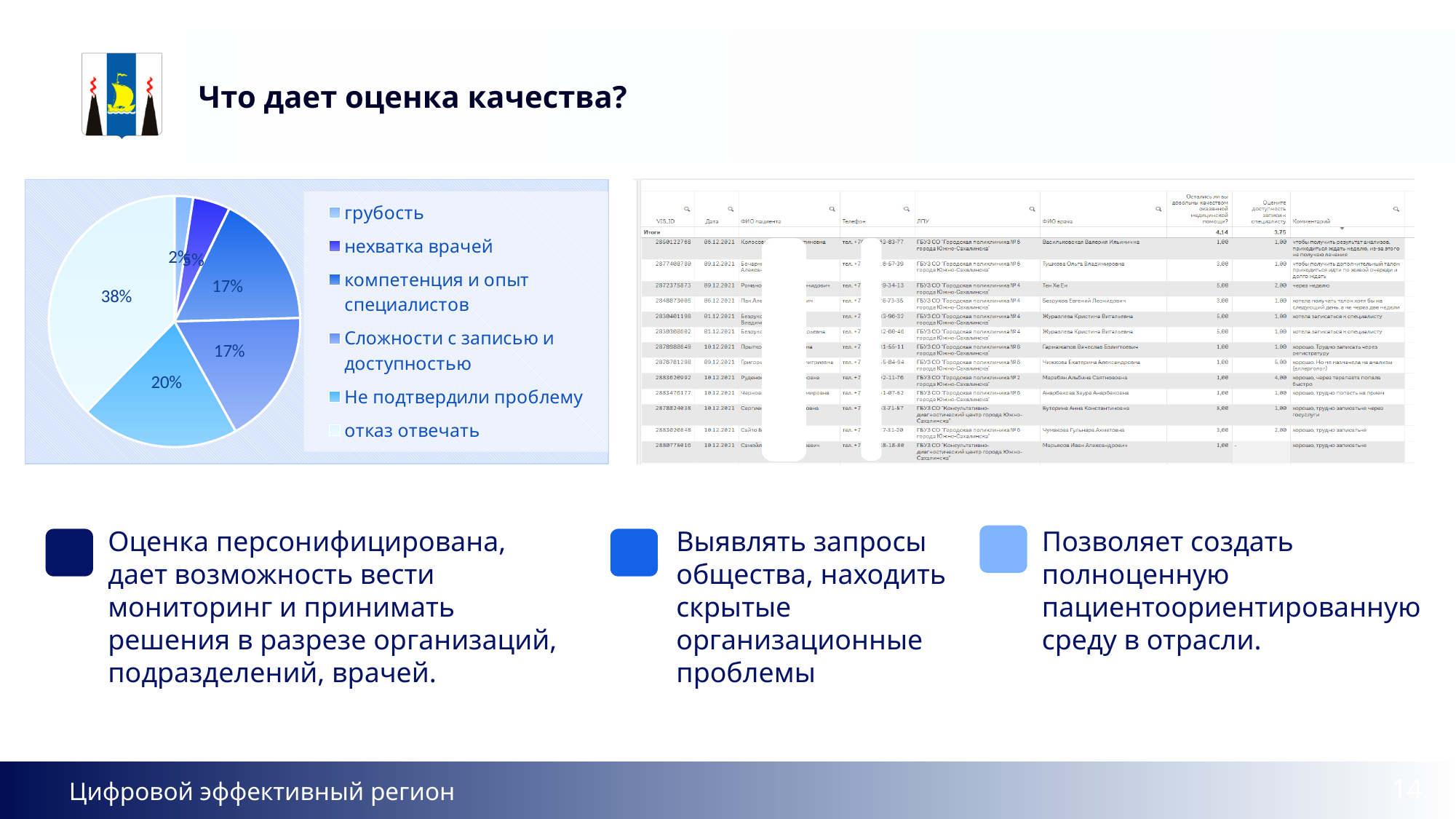
What share of the pie does "отказ отвечать" take? 38% What is the value shown for "нехватка врачей" in the pie chart? 5% What kind of chart is shown on the left of the slide? pie chart Which category has the largest share in the pie chart? отказ отвечать Which legend entry is listed first in the pie chart's legend? грубость What is the difference between the shares of "нехватка врачей" and "грубость"? 3% What is the value shown for "компетенция и опыт специалистов" in the pie chart? 17% Which is larger in the pie chart: "Не подтвердили проблему" or "Сложности с записью и доступностью"? Не подтвердили проблему What share of the pie does "Не подтвердили проблему" take? 20% What is the difference between the shares of "отказ отвечать" and "Не подтвердили проблему"? 18% How many categories does the pie chart's legend list? 6 Which category has the smallest share in the pie chart? грубость